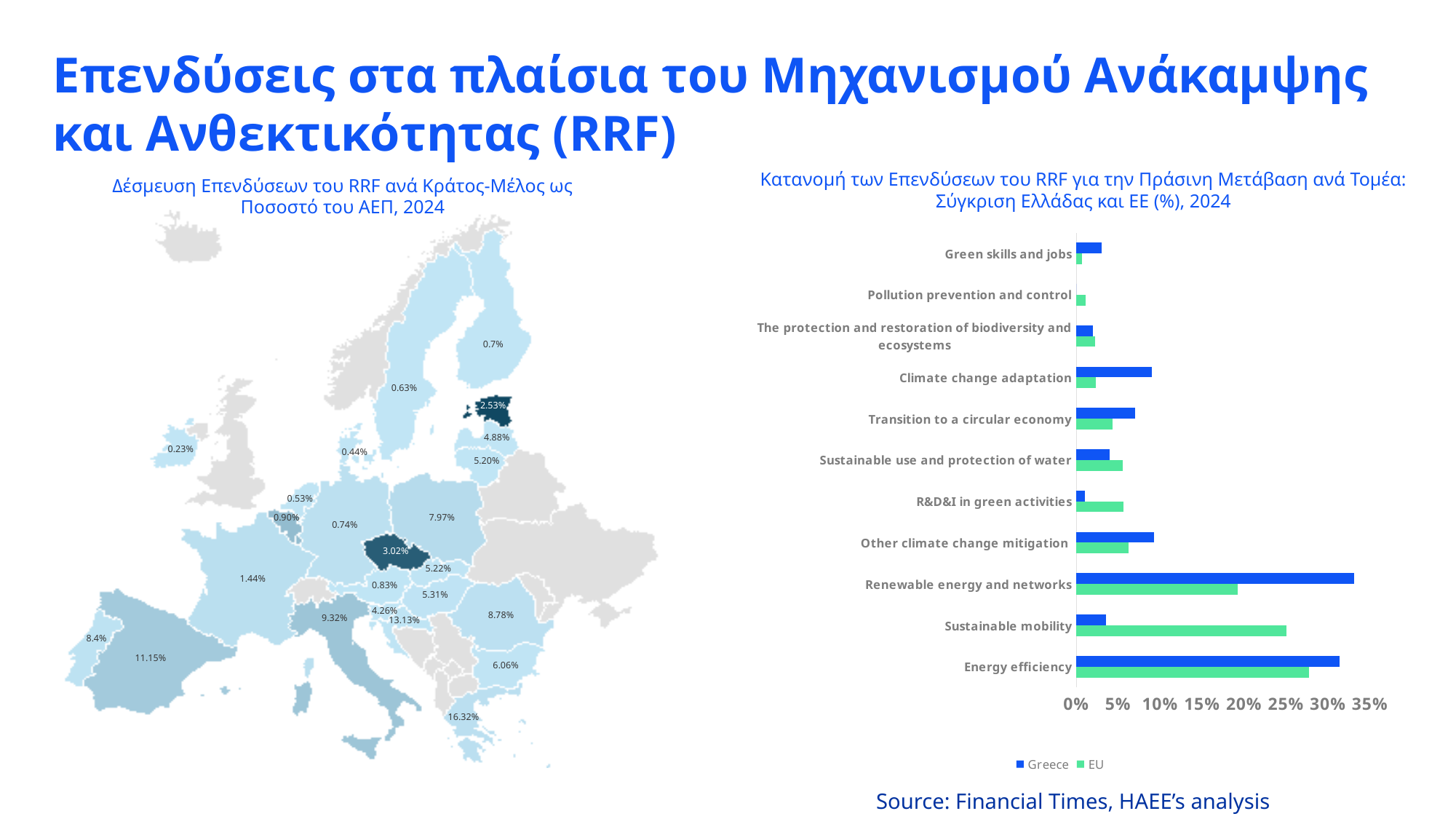
On the right-hand bar chart, how many sector categories are plotted? 11 On the right-hand bar chart, how many series does the legend list? 2 On the right-hand bar chart, is the EU value for Energy efficiency greater or less than 25%? greater On the left-hand map chart, what is the highest percentage value printed? 16.32% On the right-hand bar chart, for Sustainable mobility, which is larger: Greece or EU? EU On the right-hand bar chart, is the Greece value for Sustainable mobility greater or less than 5%? less On the right-hand bar chart, which sector has the highest value for Greece? Renewable energy and networks On the right-hand bar chart, for Renewable energy and networks, which is larger: Greece or EU? Greece On the right-hand bar chart, is the Greece value for Renewable energy and networks greater or less than 30%? greater On the right-hand bar chart, which sector has the highest value for the EU? Energy efficiency On the right-hand bar chart, what kind of chart is shown? bar chart On the right-hand bar chart, which colour represents the EU series in the legend? green